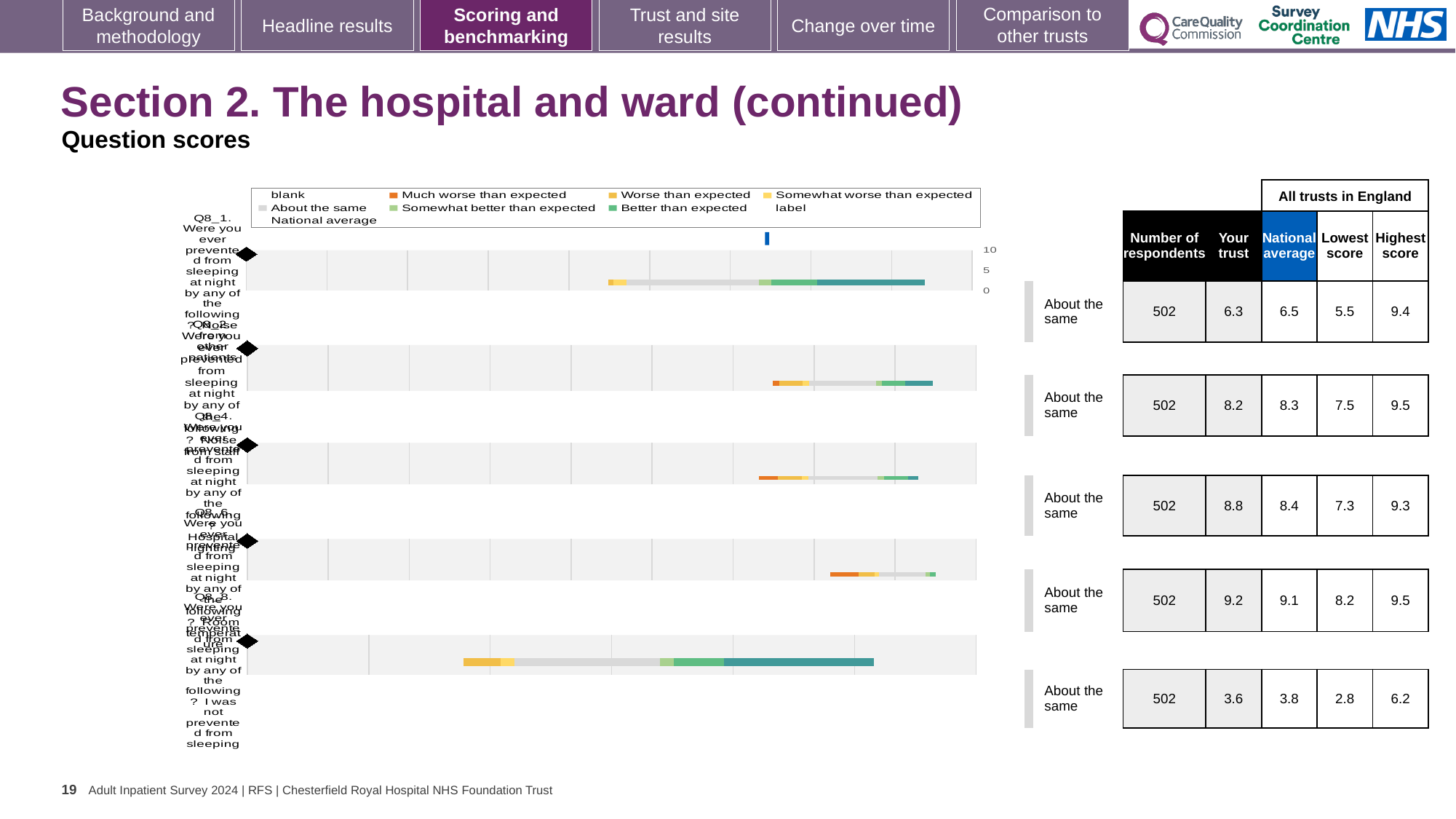
In the third row of the table, which is larger: the 'Your trust' score or the 'National average'? Your trust (8.8) Which row in the table has the lowest 'Your trust' score? the fifth (bottom) row (3.6) What kind of chart is shown on the slide? bar chart In the first row of the table, what is the difference between the 'Highest score' and the 'Lowest score'? 3.9 What benchmark label is shown next to every bar in the chart? About the same How many horizontal bars (question rows) does the chart contain? 5 In the table beside the chart, what is the 'National average' for the second row? 8.3 Which row in the table has the highest 'Your trust' score? the fourth row (9.2) How many respondents are listed for each row in the table? 502 In the table beside the chart, what is the 'Highest score' for the fifth (bottom) row? 6.2 What colour does the legend use for 'Much worse than expected'? orange In the table beside the chart, what is the 'Your trust' score for the first row? 6.3